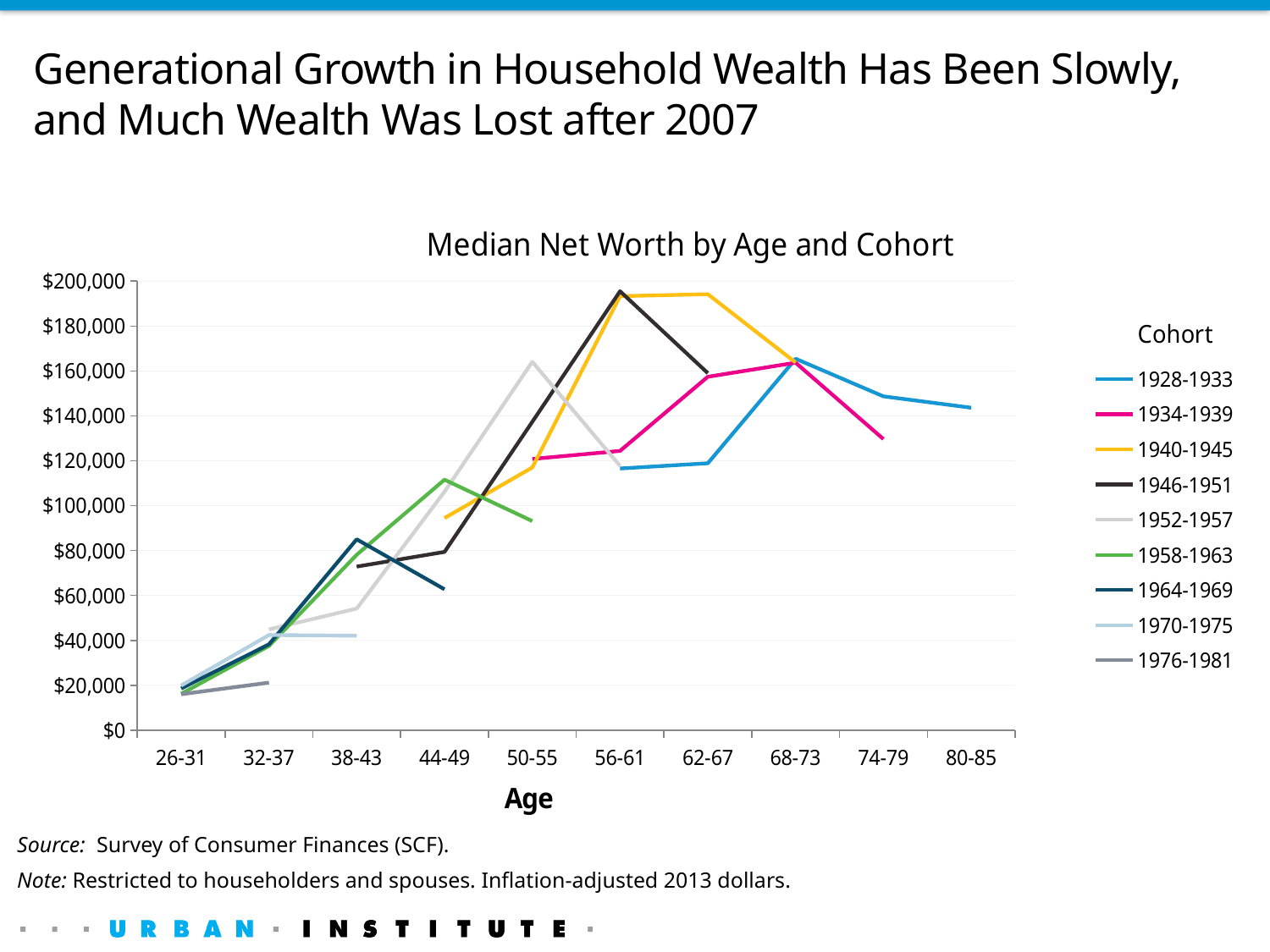
Is the median net worth for the 1946-1951 cohort at age 56-61 greater or less than $180,000? greater At age 50-55, which cohort has the higher median net worth: 1952-1957 or 1940-1945? 1952-1957 Is the median net worth for the 1976-1981 cohort at age 32-37 greater or less than $40,000? less Is the median net worth for the 1964-1969 cohort at age 44-49 greater or less than $80,000? less What kind of chart is shown on the slide? line chart How many age groups are shown on the x axis? 10 Does the median net worth for the 1928-1933 cohort rise or fall from age 68-73 to age 80-85? fall How many cohorts does the legend list? 9 At which age group is the median net worth for the 1958-1963 cohort lowest? 26-31 What is the title of the chart? Median Net Worth by Age and Cohort What is the label of the x axis? Age